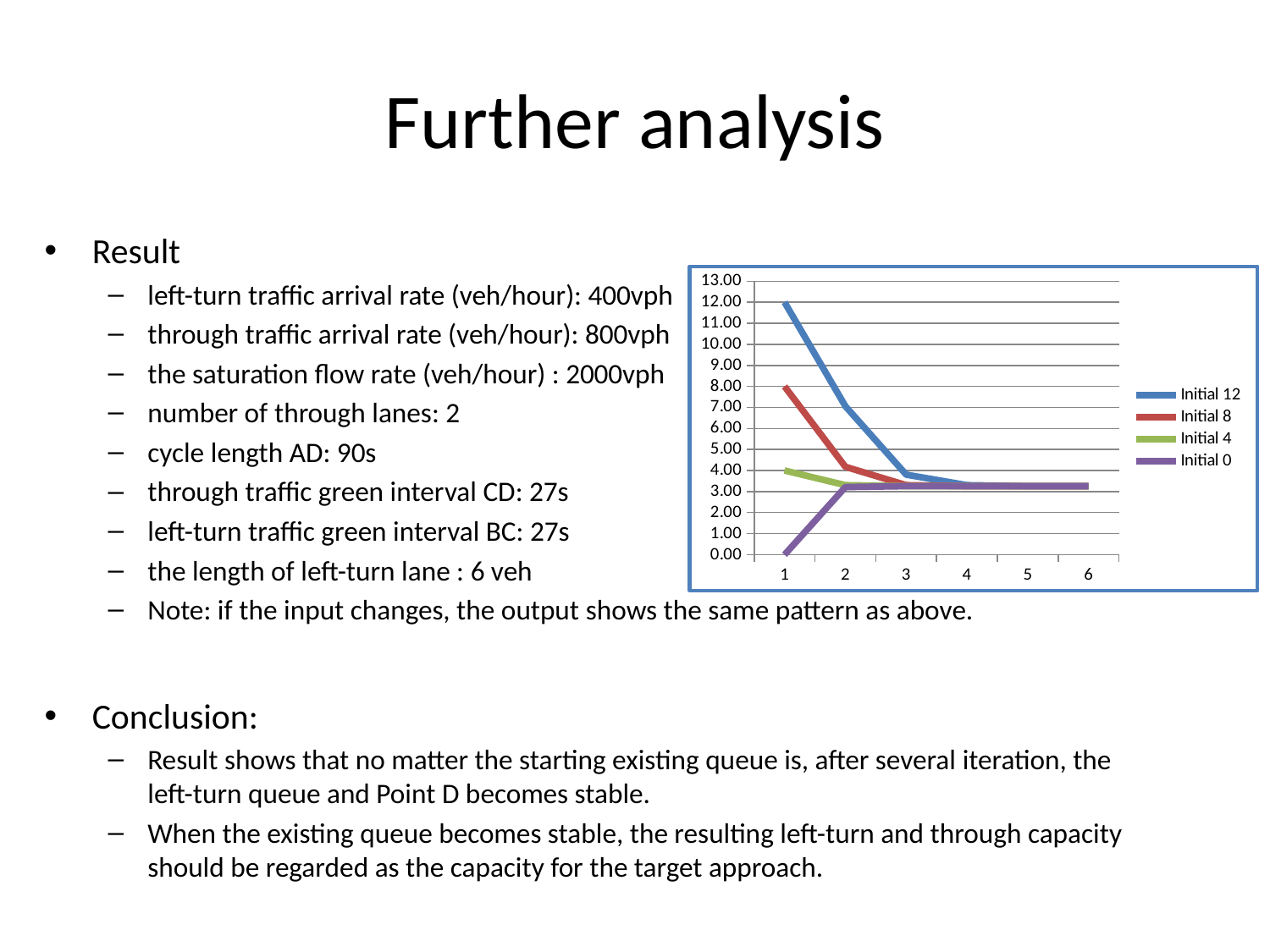
Does the Initial 12 series rise or fall from x = 1 to x = 3? fall Which series has the highest value at x = 1? Initial 12 What is the value of the Initial 12 series at x = 1? 12.00 What is the value of the Initial 8 series at x = 1? 8.00 What kind of chart is shown on the slide? line chart What colour is the line for the Initial 8 series? red Is the value of the Initial 12 series at x = 2 greater or less than 6.00? greater Which series has the lowest value at x = 1? Initial 0 At x = 2, is the value of the Initial 12 series larger or smaller than the value of the Initial 8 series? larger How many points are there along the x axis of the chart? 6 How many series does the chart legend list? 4 What is the value of the Initial 0 series at x = 1? 0.00